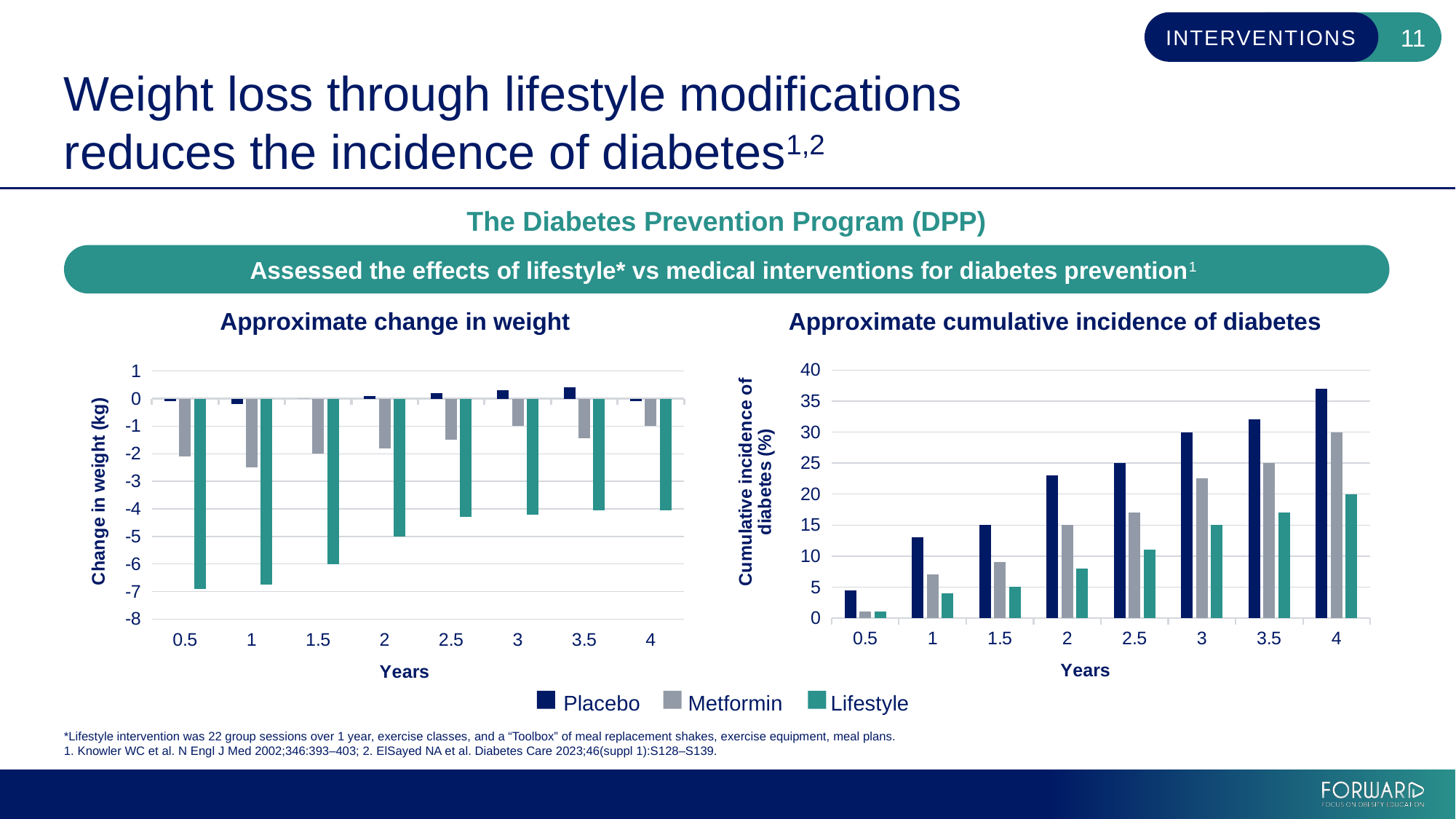
In the 'Approximate cumulative incidence of diabetes' chart, does the Placebo series rise or fall as years increase? rise What is the y-axis label of the 'Approximate change in weight' chart? Change in weight (kg) How many time points are shown on the x axis of the 'Approximate cumulative incidence of diabetes' chart? 8 In the 'Approximate cumulative incidence of diabetes' chart, which series has the lowest value at 3 years? Lifestyle In the 'Approximate cumulative incidence of diabetes' chart, is the Placebo value at 4 years greater or less than 35? greater In the 'Approximate change in weight' chart, is the Lifestyle value at 0.5 years greater or less than -6? less In the 'Approximate cumulative incidence of diabetes' chart, is the Lifestyle value at 2 years greater or less than 10? less What kind of chart is the 'Approximate change in weight' chart? bar chart In the 'Approximate change in weight' chart, which series shows the largest weight loss at 0.5 years? Lifestyle How many series does the legend list? 3 In the 'Approximate cumulative incidence of diabetes' chart, which series has the highest value at 4 years? Placebo